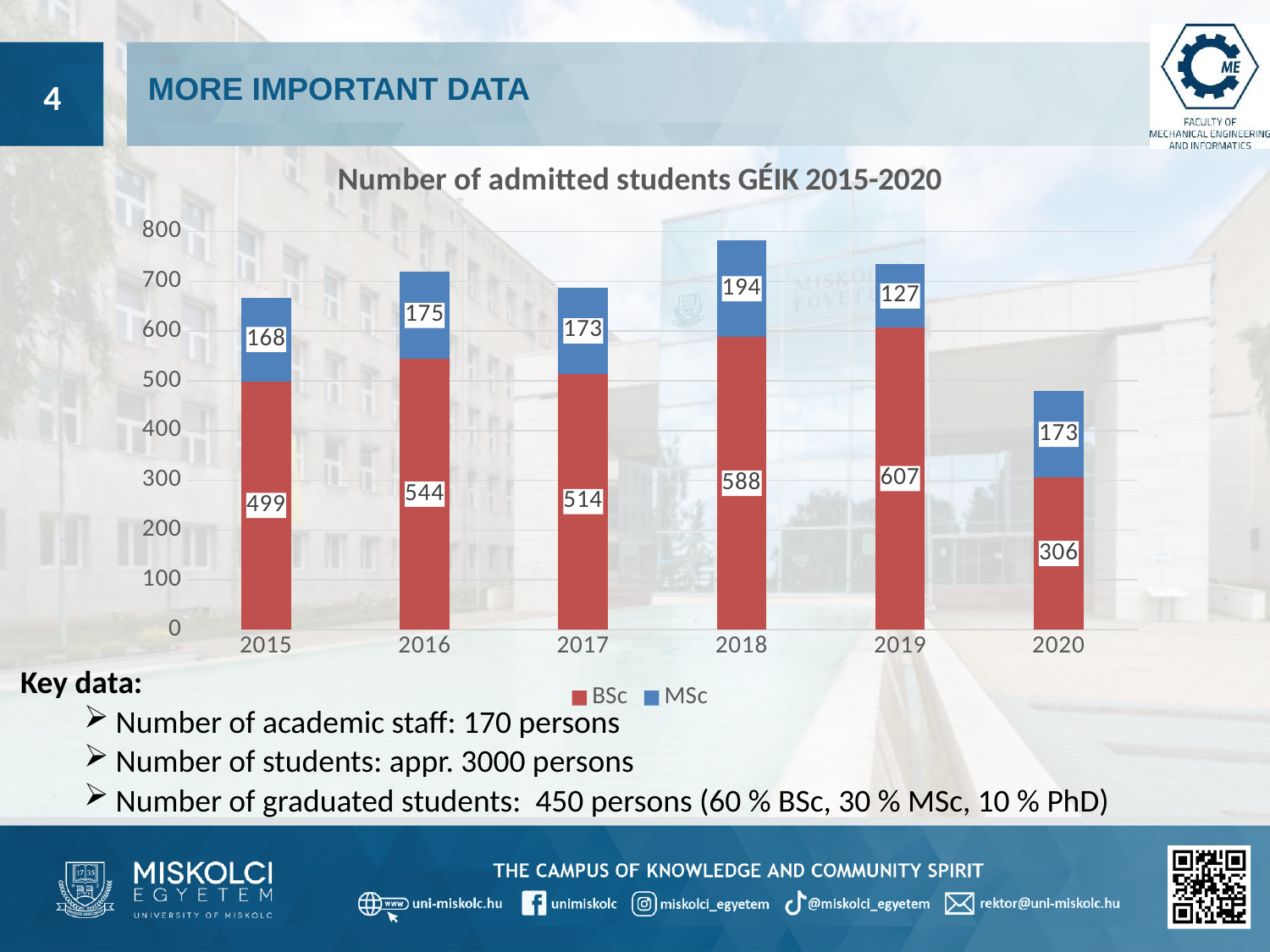
What is the total of the stacked bar for 2018? 782 How many years are shown on the x axis? 6 What is the MSc value for 2019? 127 What kind of chart is shown on the slide? stacked bar chart Which year has the highest BSc value? 2019 Which year has the highest MSc value? 2018 Which is larger, the MSc value for 2016 or the MSc value for 2017? 2016 What is the BSc value for 2018? 588 Is the total of the stacked bar for 2020 greater or less than 500? less How many series does the legend list? 2 What is the difference between the BSc values for 2019 and 2020? 301 Which year has the lowest BSc value? 2020